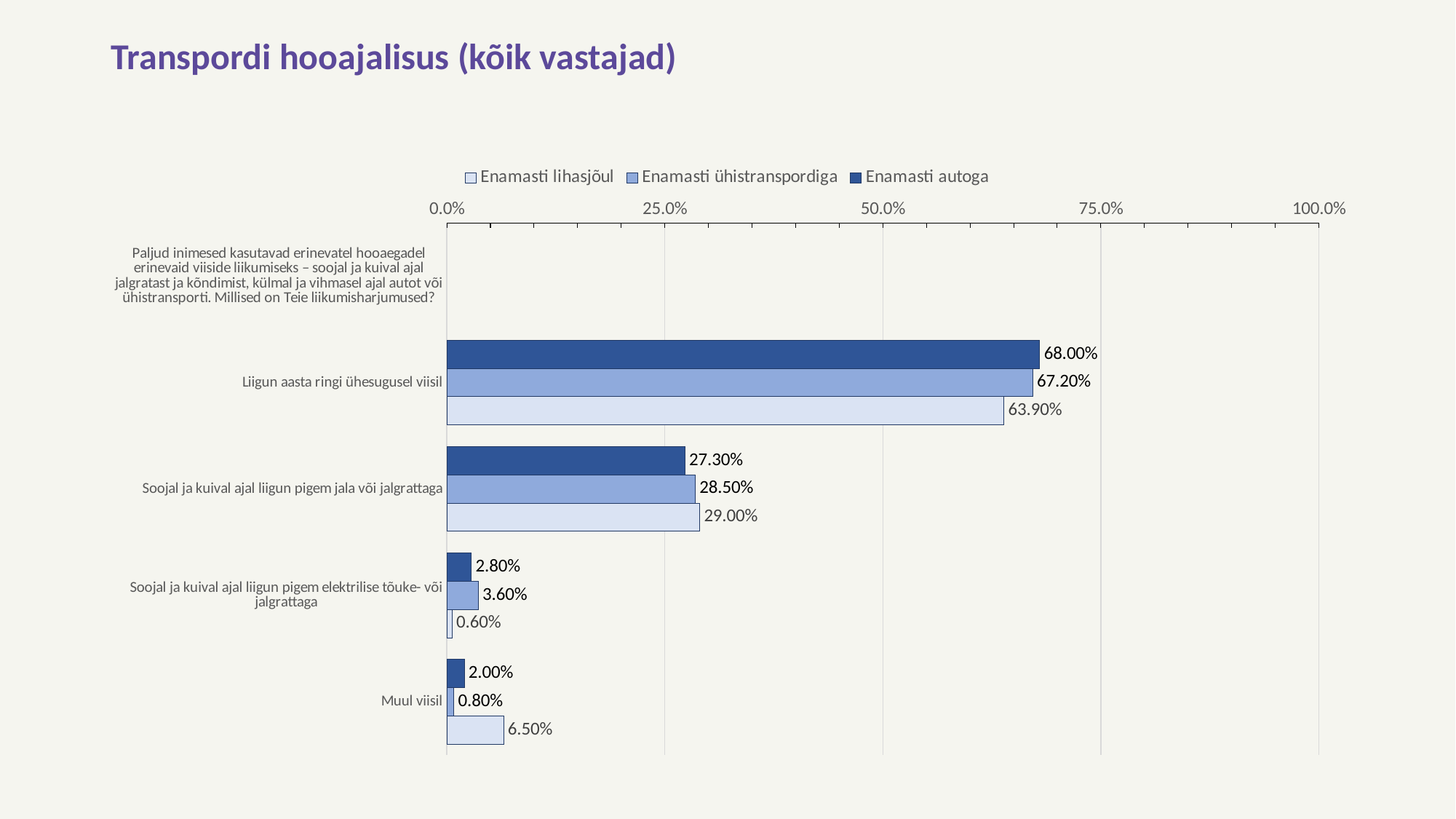
What is the value for "Enamasti ühistranspordiga" in the category "Soojal ja kuival ajal liigun pigem elektrilise tõuke- või jalgrattaga"? 3.60% Is the value for "Enamasti ühistranspordiga" in the category "Liigun aasta ringi ühesugusel viisil" greater or less than 50.0%? greater Which series has the lowest value in the category "Muul viisil"? Enamasti ühistranspordiga What is the title of the slide? Transpordi hooajalisus (kõik vastajad) What kind of chart is shown on the slide? Bar chart How many series does the legend list? 3 What is the value for "Enamasti autoga" in the category "Liigun aasta ringi ühesugusel viisil"? 68.00% What is the value for "Enamasti lihasjõul" in the category "Muul viisil"? 6.50% Which series has the highest value in the category "Liigun aasta ringi ühesugusel viisil"? Enamasti autoga In the category "Soojal ja kuival ajal liigun pigem jala või jalgrattaga", which is larger: "Enamasti lihasjõul" or "Enamasti autoga"? Enamasti lihasjõul What is the difference between the "Enamasti autoga" and "Enamasti lihasjõul" values in the category "Liigun aasta ringi ühesugusel viisil"? 4.10% What is the value for "Enamasti lihasjõul" in the category "Soojal ja kuival ajal liigun pigem jala või jalgrattaga"? 29.00%